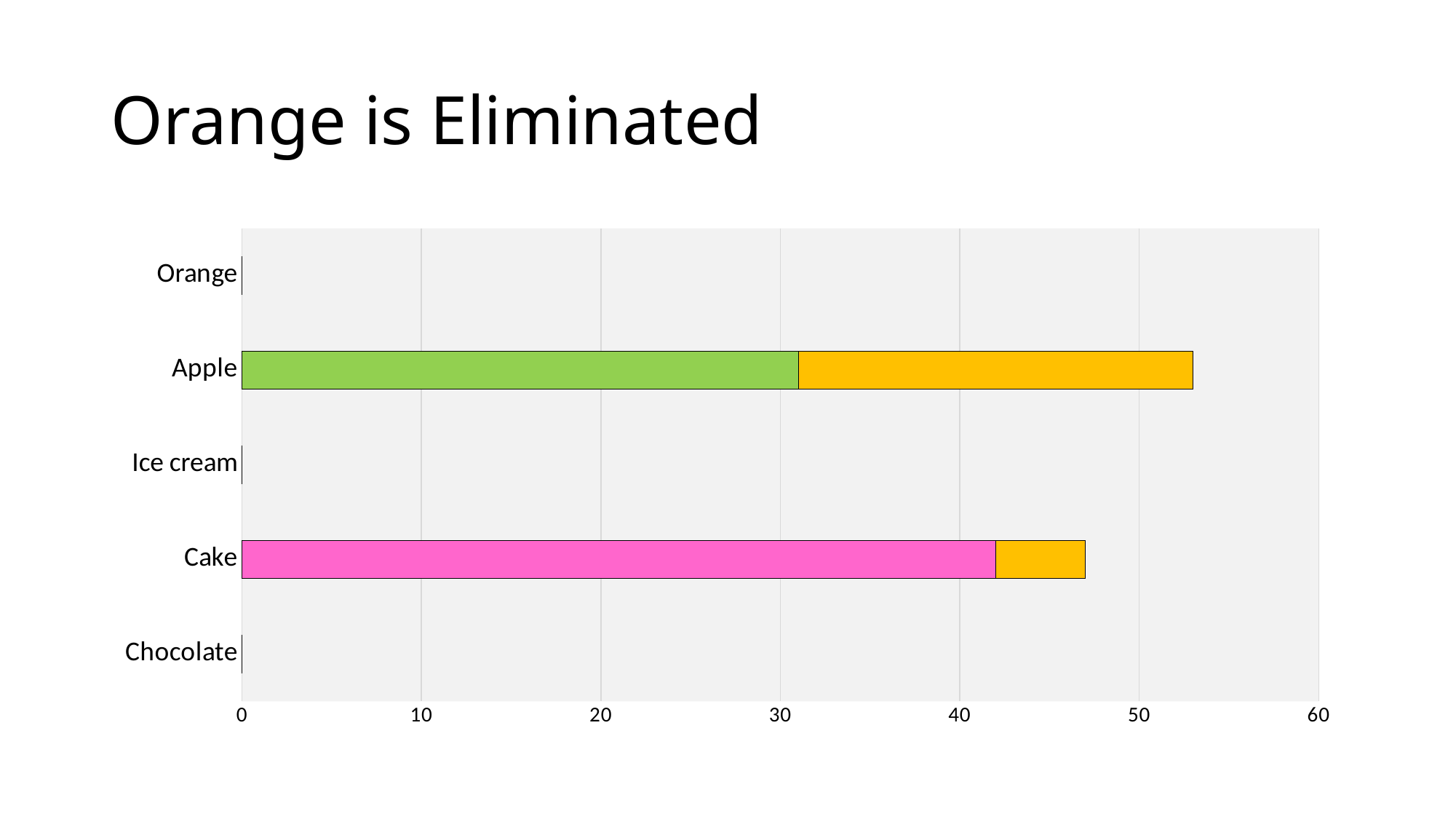
What is the highest value shown on the horizontal axis of the chart? 60 How many categories are listed on the vertical axis of the chart? 5 What kind of chart is shown on the slide? bar chart What is the title of the slide? Orange is Eliminated Is the green segment of the Apple bar greater or less than 30? greater Is the total bar length for Cake greater or less than 50? less Is the total bar length for Cake greater or less than 40? greater Which categories in the chart have no visible bar? Orange, Ice cream, Chocolate Which category has the longest bar in the chart? Apple Which of the two, Apple or Cake, has the longer total bar? Apple